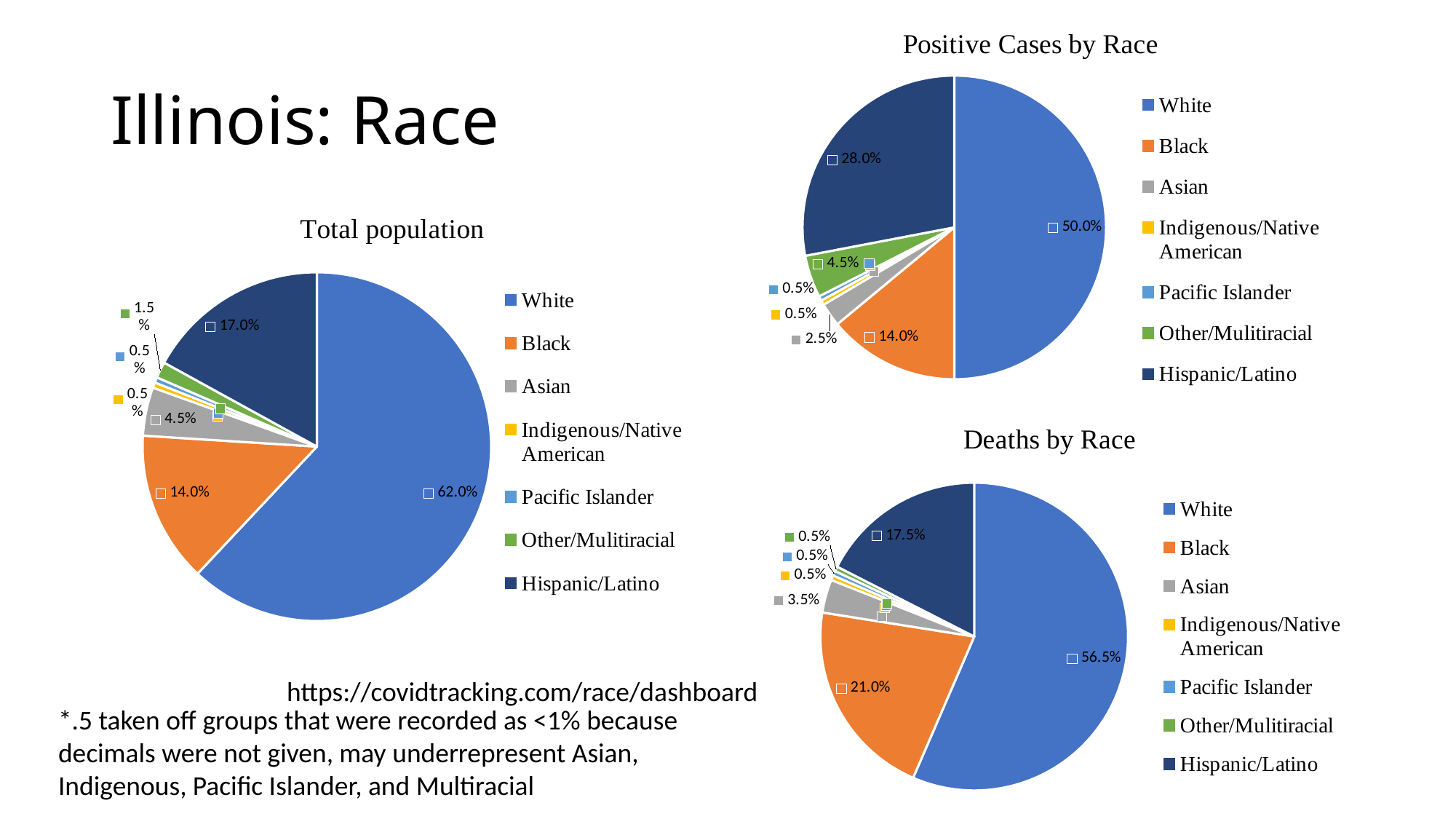
What kind of chart is the Total population chart? Pie chart In the Total population chart, which category has the largest slice? White In the Positive Cases by Race chart, what share is Hispanic/Latino? 28.0% In the Positive Cases by Race chart, which category has the largest slice? White Is the Black share larger in the Deaths by Race chart or in the Positive Cases by Race chart? Deaths by Race In the Deaths by Race chart, what is the difference between the White share and the Hispanic/Latino share? 39.0% How many categories does the legend of the Deaths by Race chart list? 7 In the Positive Cases by Race chart, what is the difference between the Hispanic/Latino share and the Black share? 14.0% How many pie charts are shown on the slide? 3 In the Deaths by Race chart, what share is Asian? 3.5% In the Deaths by Race chart, what share is Black? 21.0% In the Total population chart, what share is White? 62.0%